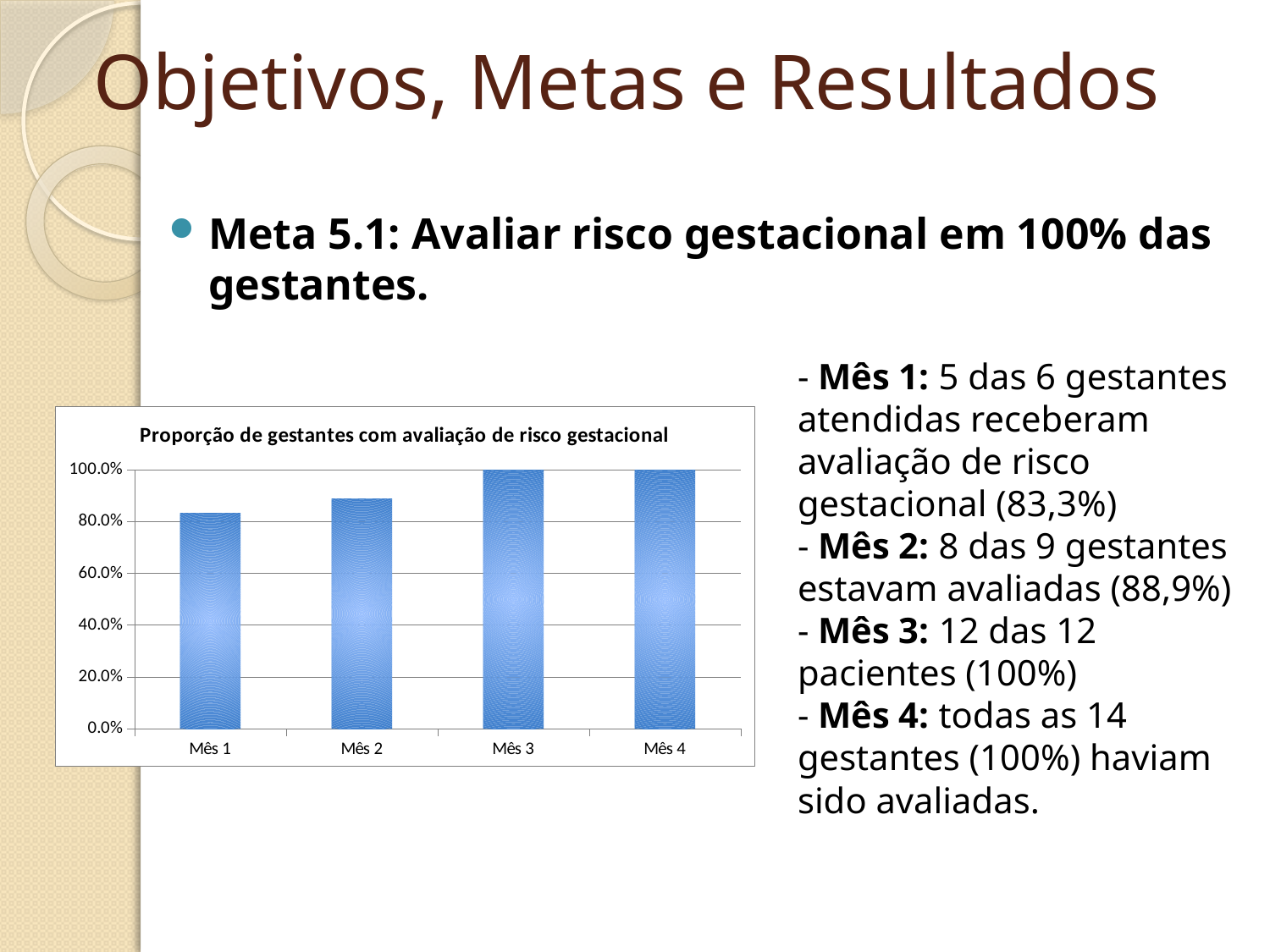
Is the value for Mês 1 greater or less than 80.0%? greater Which month has the lowest value in the chart? Mês 1 What is the difference between the values for Mês 3 and Mês 4? 0.0% Do the values rise or fall from Mês 1 to Mês 4? rise What is the value for Mês 3 in the chart? 100.0% What is the value for Mês 4 in the chart? 100.0% Is the value for Mês 2 greater or less than 100.0%? less Is the value for Mês 1 greater or less than 100.0%? less What kind of chart is shown on the slide? bar chart What is the title of the chart? Proporção de gestantes com avaliação de risco gestacional Which is larger, the value for Mês 2 or the value for Mês 3? Mês 3 How many months (categories) are plotted in the chart? 4